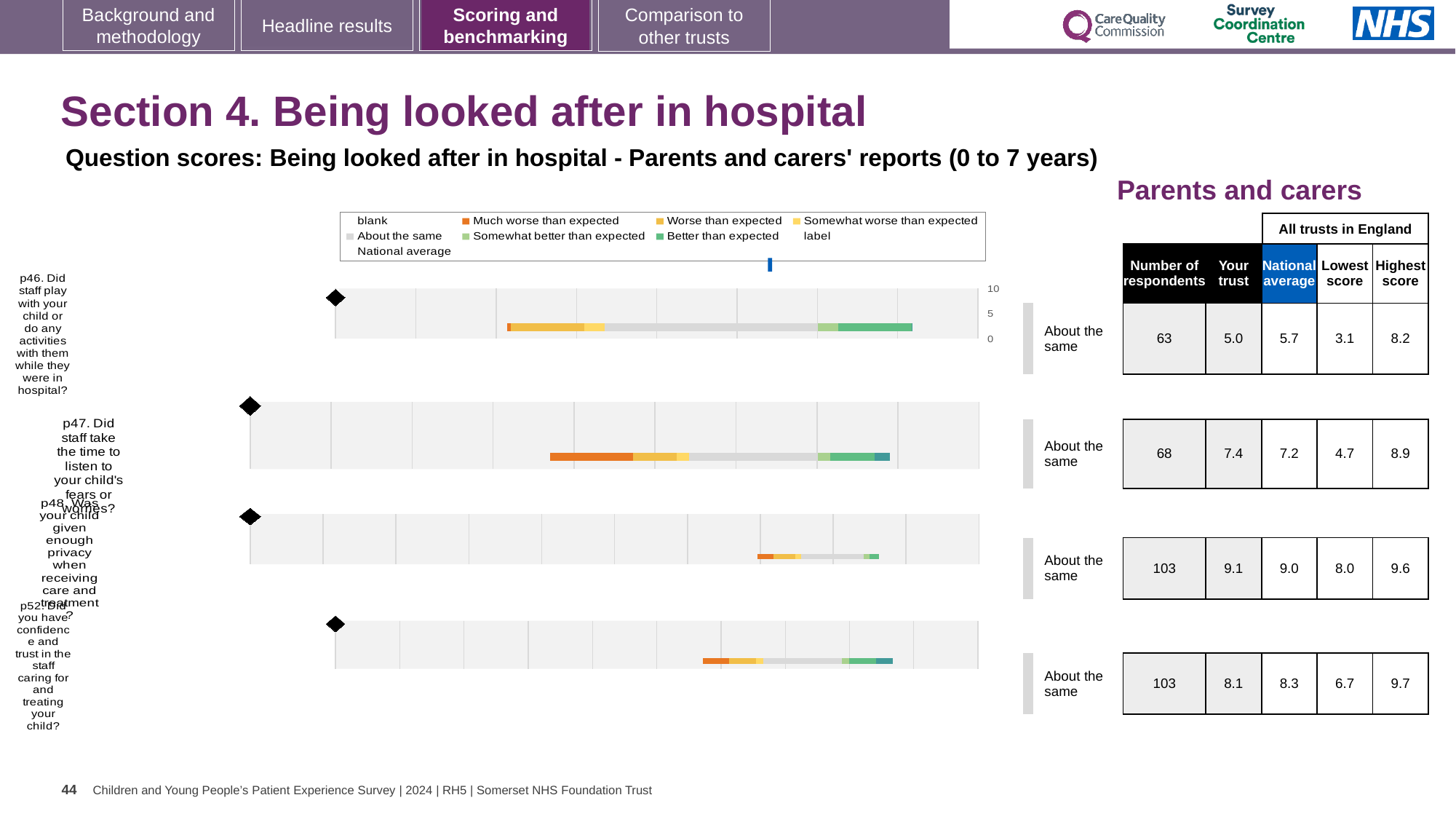
What is the 'Your trust' score for p46 (Did staff play with your child or do any activities with them while they were in hospital?)? 5.0 What is the highest score among all trusts in England for p48 (Was your child given enough privacy when receiving care and treatment?)? 9.6 Which question has the highest 'Your trust' score on this slide? p48 How many questions (p46, p47, p48, p52) have a score chart on this slide? 4 What kind of chart is used to show the question scores on this slide? Stacked bar chart What benchmark category is shown for p52 on this slide? About the same What is the national average score for p47 (Did staff take the time to listen to your child's fears or worries?)? 7.2 For p47, which is larger: the 'Your trust' score or the national average? Your trust Which question has the lowest 'Your trust' score on this slide? p46 How many respondents answered p52 (Did you have confidence and trust in the staff caring for and treating your child?)? 103 What is the maximum value shown on the score axis of the charts? 10 For p46, what is the difference between the national average and the 'Your trust' score? 0.7